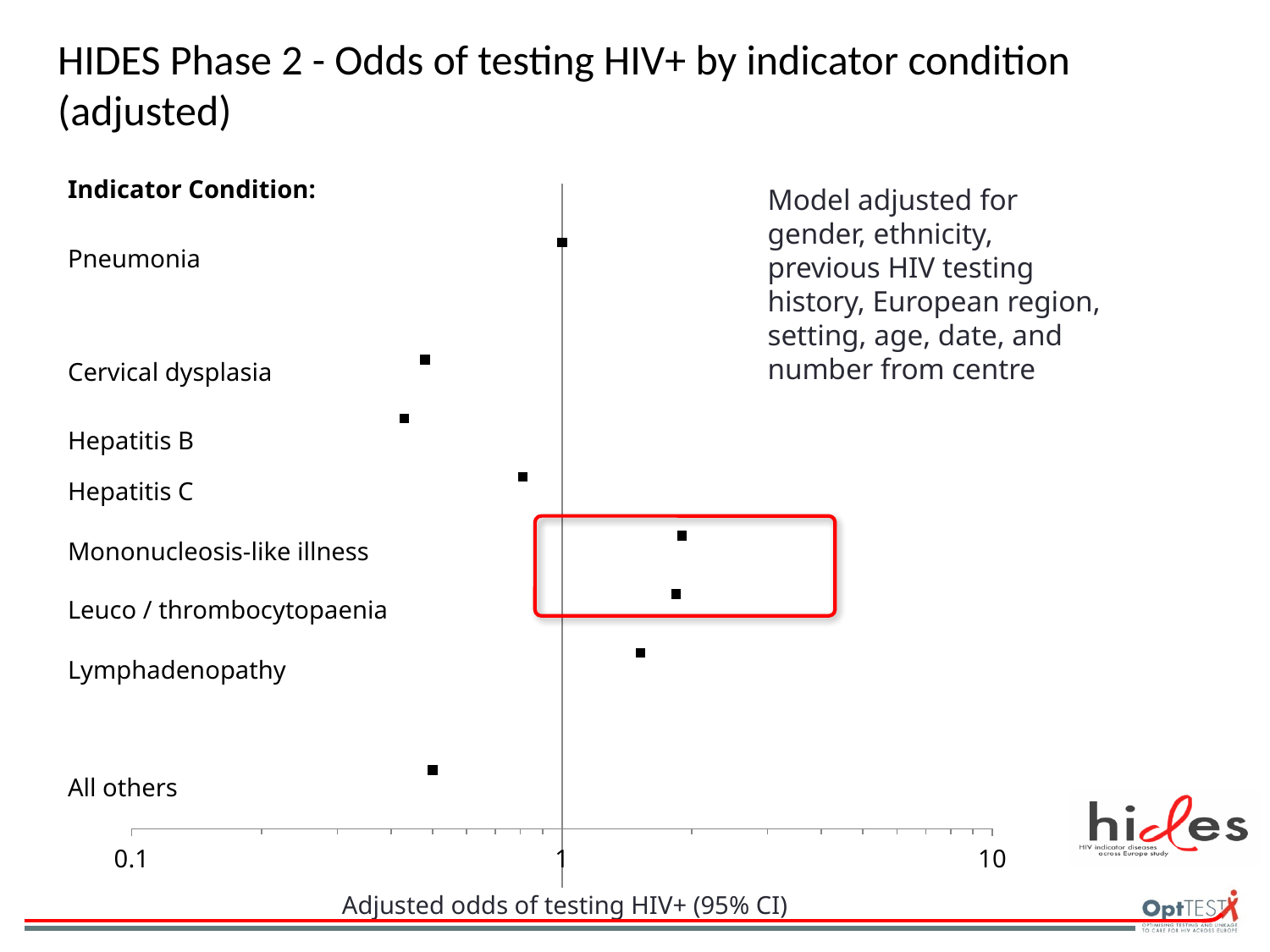
Is the adjusted odds value for Hepatitis B greater or less than 1? less Is the adjusted odds value for Lymphadenopathy greater or less than 1? greater Which indicator condition has the lowest adjusted odds of testing HIV+? Hepatitis B Which has the higher adjusted odds of testing HIV+: Hepatitis C or Mononucleosis-like illness? Mononucleosis-like illness Is the adjusted odds value for Mononucleosis-like illness greater or less than 1? greater What kind of chart is shown on the slide? scatter (dot) plot How many indicator conditions are plotted on the chart? 8 Which has the higher adjusted odds of testing HIV+: Hepatitis B or Lymphadenopathy? Lymphadenopathy What are the minimum and maximum tick values shown on the horizontal axis? 0.1 and 10 What is the label of the horizontal axis? Adjusted odds of testing HIV+ (95% CI)